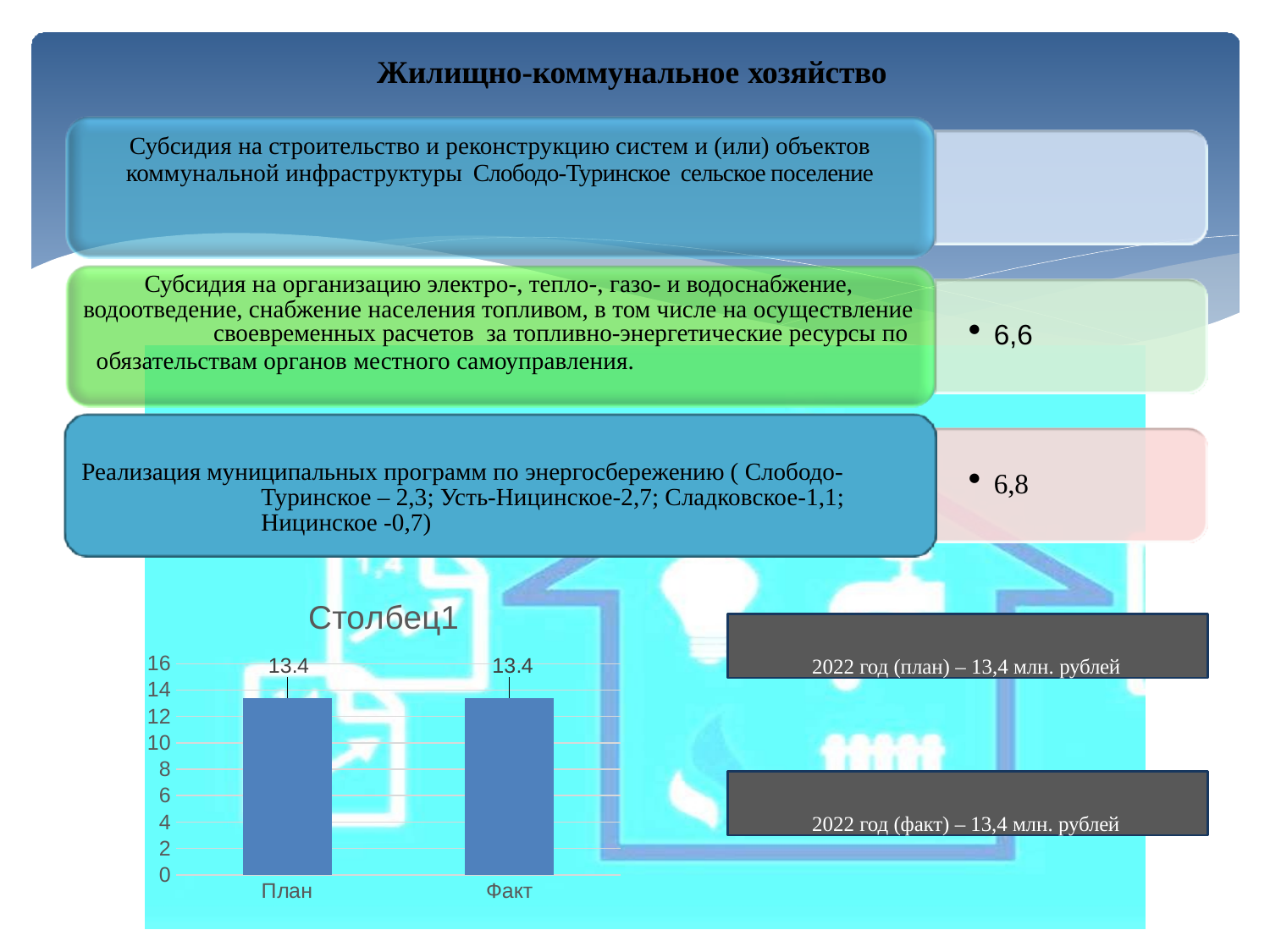
What is the value of the Факт bar in the chart? 13.4 What is the value of the План bar in the chart? 13.4 What is the difference between the План and Факт values in the chart? 0 Is the value for Факт greater or less than 14? less Is the value for План greater or less than 10? greater Do the values rise, fall, or stay the same from План to Факт? stay the same What kind of chart is shown on the slide? bar chart What is the highest value shown on the chart's vertical axis? 16 How many bars are plotted in the chart? 2 What is the title of the chart? Столбец1